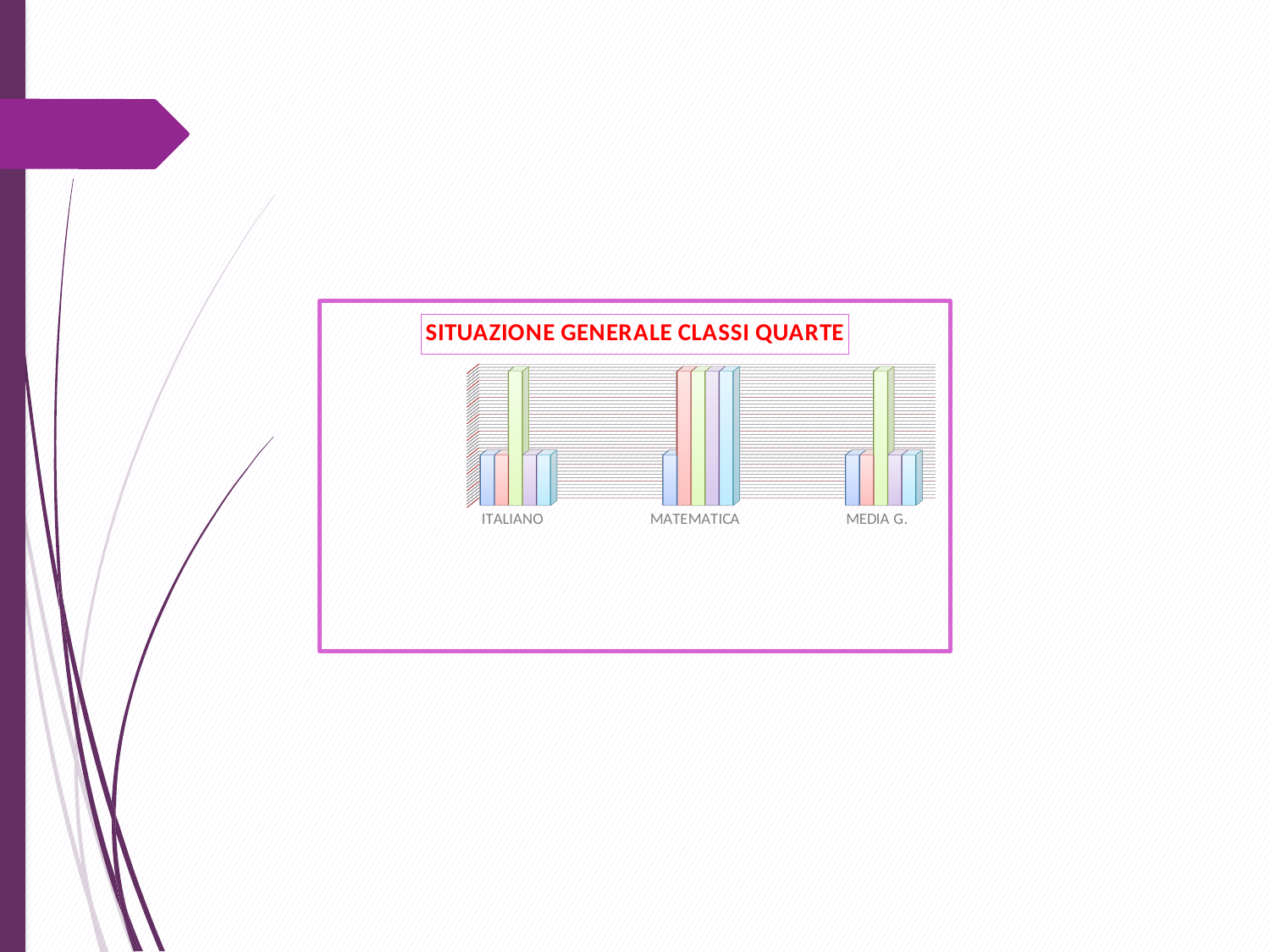
In the MATEMATICA category, which coloured bar is the shortest? blue (leftmost) How many bars are plotted for each category in the chart? 5 How many categories are shown on the x axis of the chart? 3 In the MATEMATICA category, which is taller: the pink bar or the blue bar? pink bar In the ITALIANO category, which is taller: the green bar or the blue bar? green bar Does the chart display a legend? No In the MEDIA G. category, which coloured bar is the tallest? green What kind of chart is shown on the slide? bar chart Which category has the most tall bars in the chart? MATEMATICA In the ITALIANO category, which coloured bar is the tallest? green What is the title of the chart? SITUAZIONE GENERALE CLASSI QUARTE